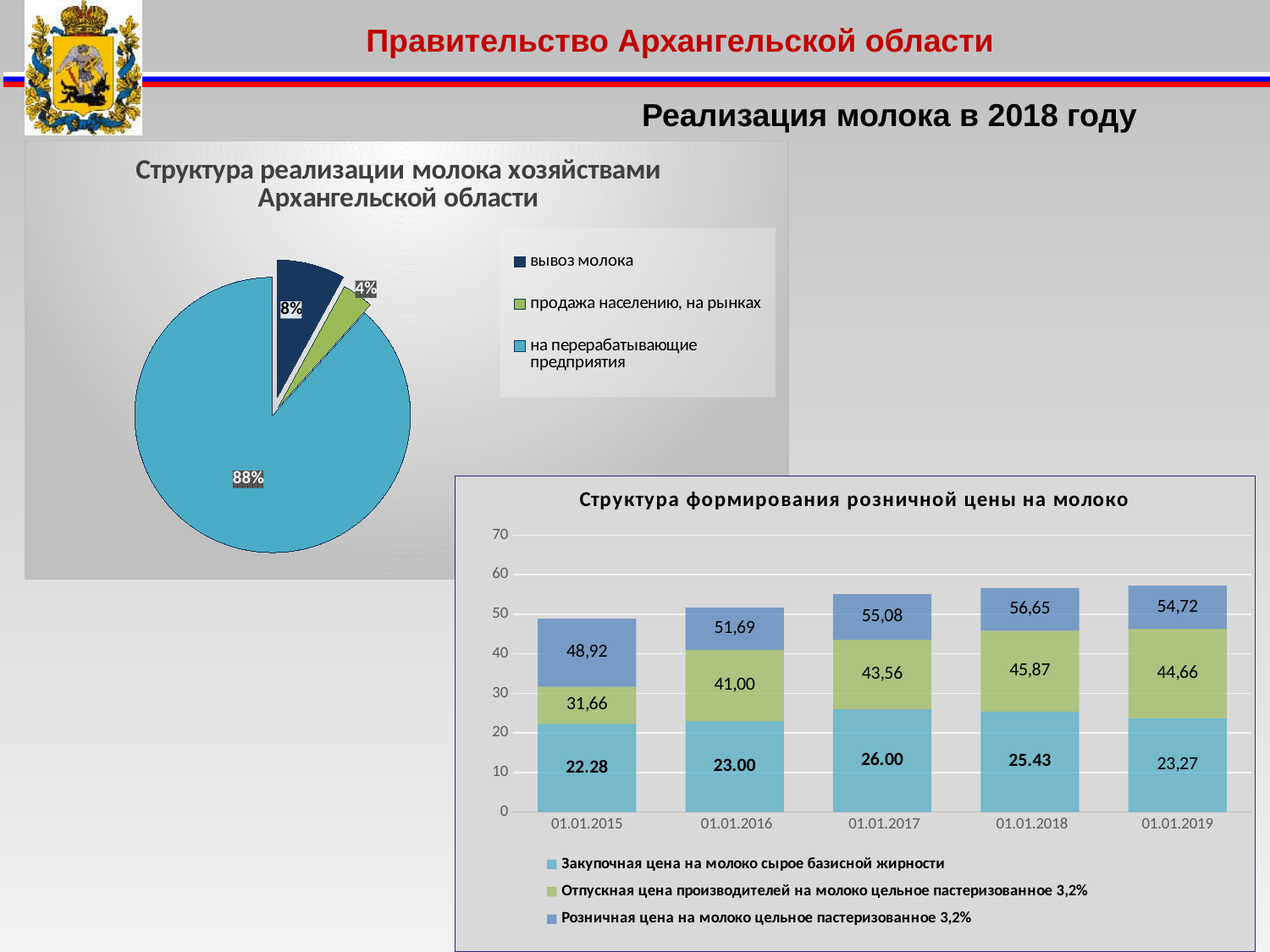
In the pie chart 'Структура реализации молока хозяйствами Архангельской области', what share is labelled for 'вывоз молока'? 8% How many series does the legend of the chart 'Структура формирования розничной цены на молоко' list? 3 How many categories does the legend of the pie chart 'Структура реализации молока хозяйствами Архангельской области' list? 3 In the chart 'Структура формирования розничной цены на молоко', what is the difference between the labelled values for 'Отпускная цена производителей на молоко цельное пастеризованное 3,2%' at 01.01.2018 and 01.01.2019? 1,21 In the chart 'Структура формирования розничной цены на молоко', at which date is the labelled value for 'Закупочная цена на молоко сырое базисной жирности' the lowest? 01.01.2015 In the chart 'Структура формирования розничной цены на молоко', what value is labelled for 'Розничная цена на молоко цельное пастеризованное 3,2%' at 01.01.2018? 56,65 What kind of chart is 'Структура формирования розничной цены на молоко'? Stacked bar chart In the pie chart 'Структура реализации молока хозяйствами Архангельской области', which category has the smallest slice? продажа населению, на рынках In the pie chart 'Структура реализации молока хозяйствами Архангельской области', what share is labelled for 'на перерабатывающие предприятия'? 88% In the chart 'Структура формирования розничной цены на молоко', at which date is the labelled value for 'Розничная цена на молоко цельное пастеризованное 3,2%' the highest? 01.01.2018 In the chart 'Структура формирования розничной цены на молоко', what value is labelled for 'Отпускная цена производителей на молоко цельное пастеризованное 3,2%' at 01.01.2016? 41,00 In the chart 'Структура формирования розничной цены на молоко', what value is labelled for 'Закупочная цена на молоко сырое базисной жирности' at 01.01.2017? 26.00